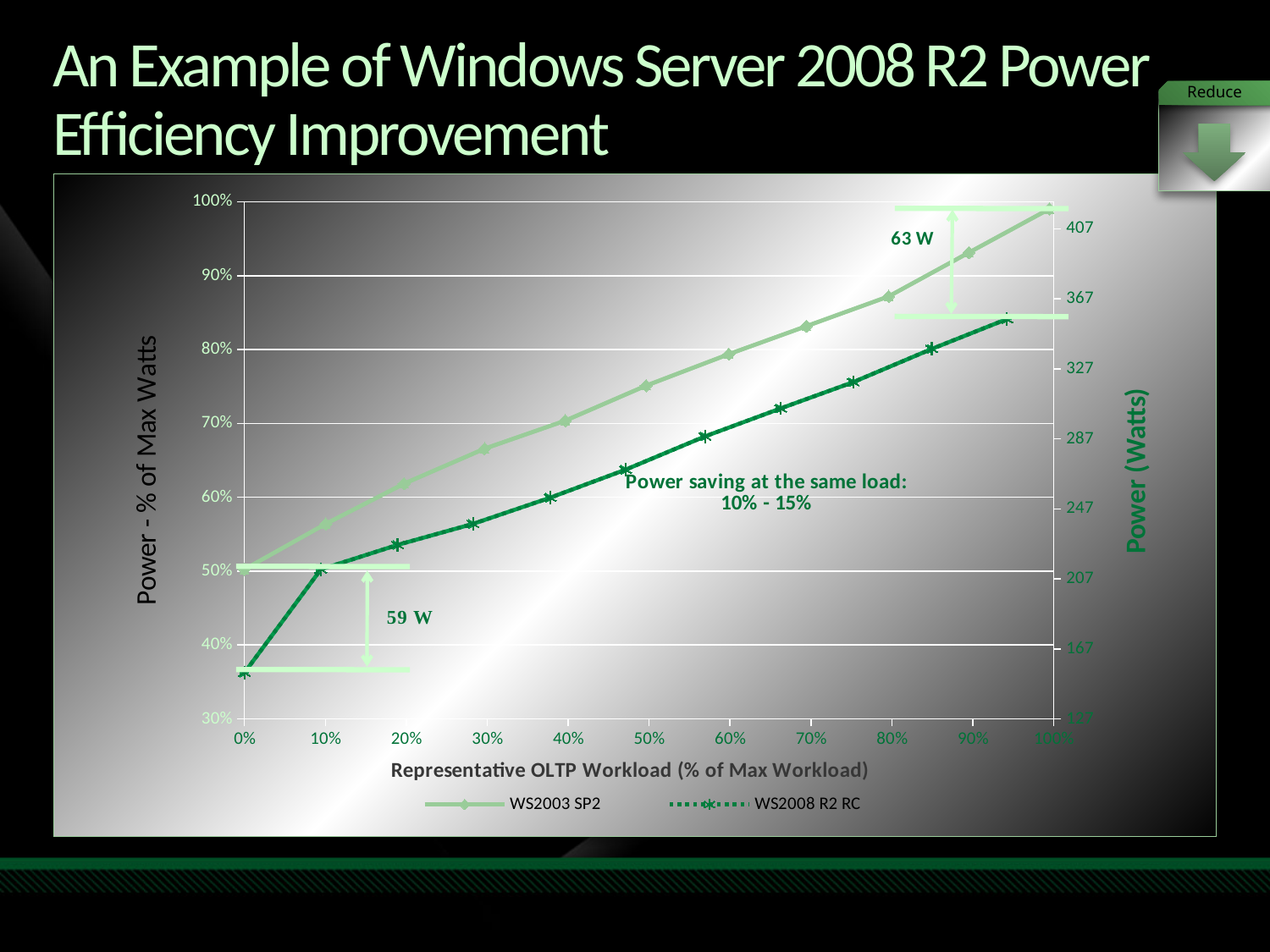
Do the values for WS2003 SP2 rise or fall as workload increases along the x axis? rise Is the value for WS2008 R2 RC at 100% workload greater or less than 90%? less What power saving in watts is annotated at 0% workload? 59 W What power saving in watts is annotated at 100% workload? 63 W What is the title of the x axis? Representative OLTP Workload (% of Max Workload) Is the value for WS2008 R2 RC at 0% workload greater or less than 40%? less What kind of chart is shown on the slide? line chart How many series does the legend list? 2 What are the two series named in the legend? WS2003 SP2 and WS2008 R2 RC At 50% workload, which series has the higher power value, WS2003 SP2 or WS2008 R2 RC? WS2003 SP2 Is the value for WS2003 SP2 at 100% workload greater or less than 90%? greater